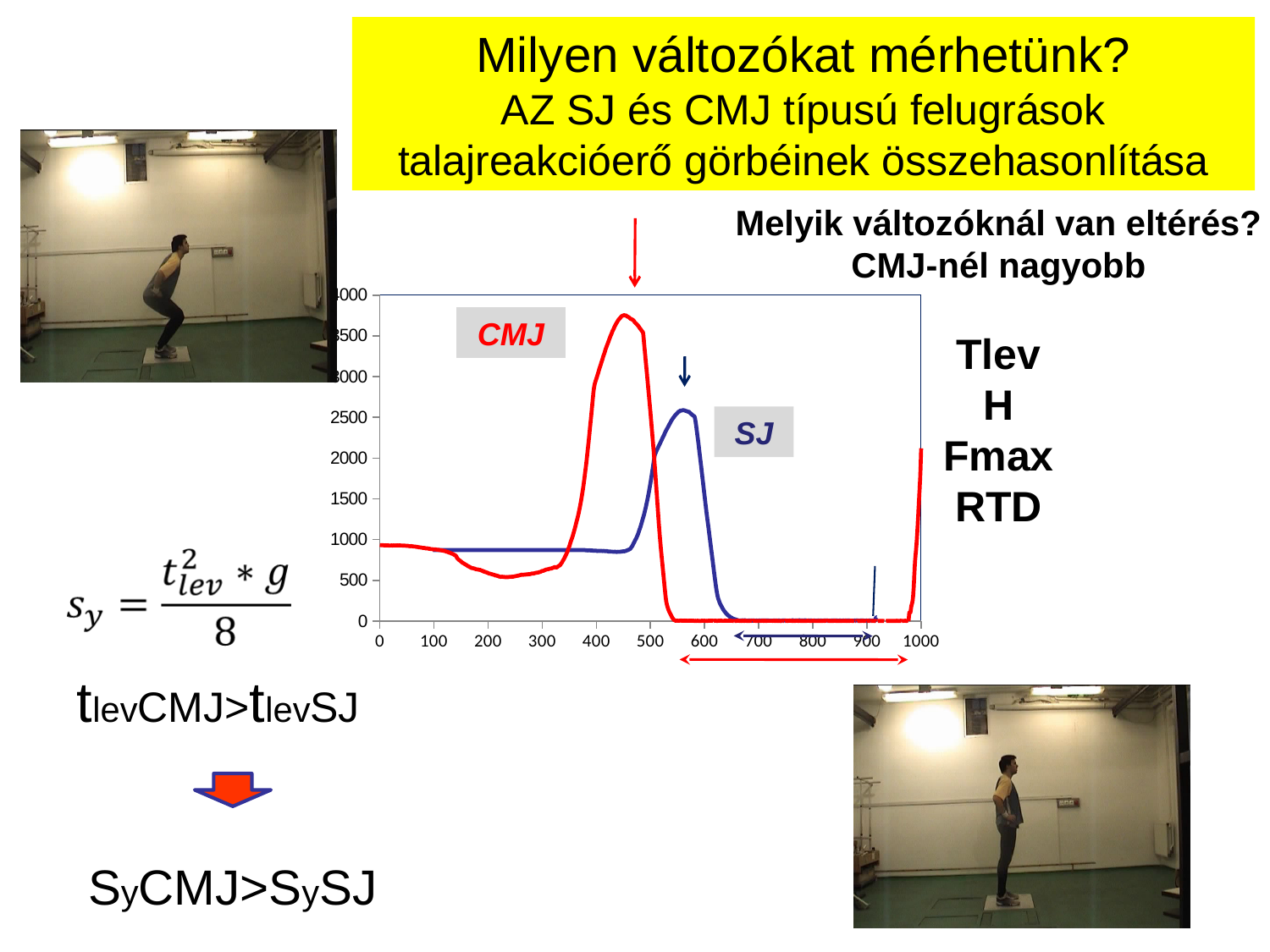
What colour is the CMJ curve? red Is the peak value of the SJ curve greater or less than 2000? greater Is the lowest value of the CMJ curve before its peak (around x = 200–300) greater or less than 1000? less Is the peak value of the SJ curve greater or less than 3000? less What kind of chart is shown on the slide? line chart Which curve has the lower peak value? SJ Which curve reaches its peak earlier along the x axis, CMJ or SJ? CMJ What is the highest value shown on the y axis? 4000 How many curves (series) are plotted on the chart? 2 Which curve reaches the higher peak value, CMJ or SJ? CMJ